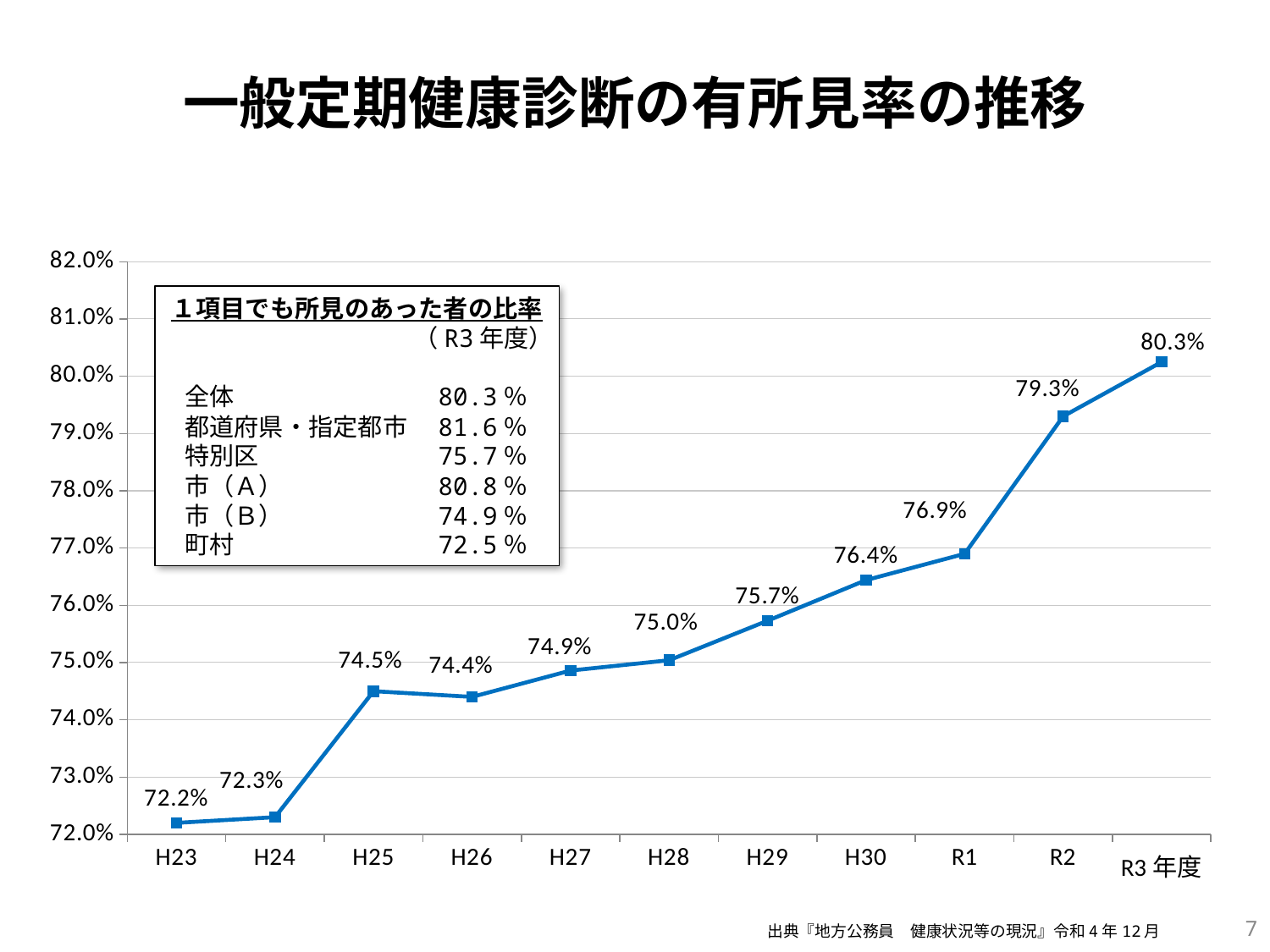
What is the difference between the values for R2 and R1? 2.4% What is the value for H25? 74.5% What kind of chart is shown on the slide? line chart Do the values generally rise or fall from H23 to R3? rise Which year has the lowest value? H23 What is the value for H28? 75.0% What is the value for R2? 79.3% What is the difference between the values for R3 and H23? 8.1% Which is larger, the value for H25 or the value for H26? H25 Which year has the highest value? R3 How many data points are plotted on the line? 11 What is the title of the chart? 一般定期健康診断の有所見率の推移